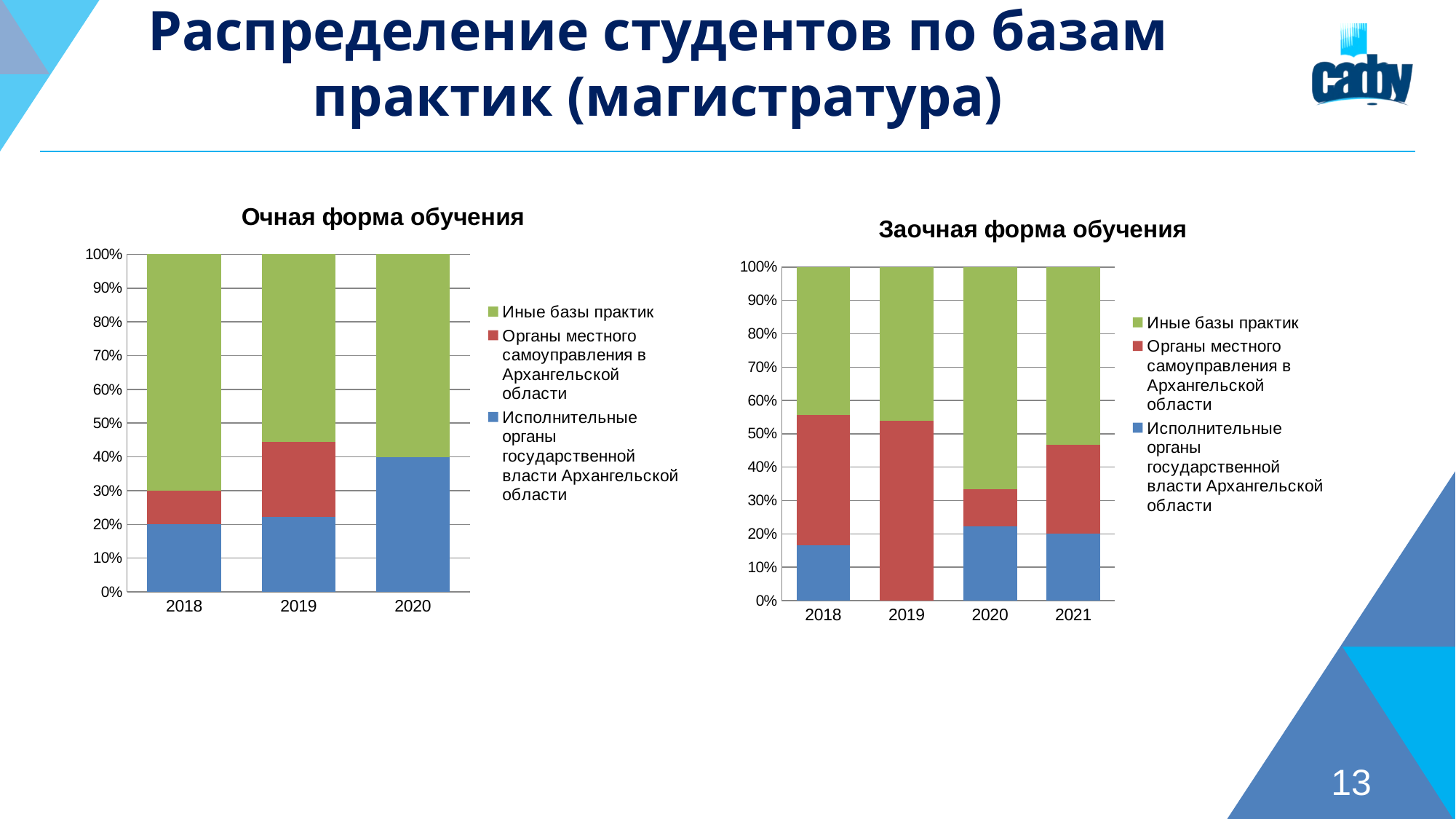
What colour represents 'Иные базы практик' in the 'Очная форма обучения' chart? green How many years are shown on the x axis of the 'Заочная форма обучения' chart? 4 In the 'Очная форма обучения' chart, is the share for 'Иные базы практик' in 2018 greater or less than 60%? greater How many years are shown on the x axis of the 'Очная форма обучения' chart? 3 In the 'Заочная форма обучения' chart, is the share for 'Иные базы практик' in 2020 greater or less than 60%? greater In the 'Очная форма обучения' chart, which year has the largest share for 'Исполнительные органы государственной власти Архангельской области'? 2020 In the 'Заочная форма обучения' chart, is the share for 'Исполнительные органы государственной власти Архангельской области' in 2018 greater or less than 20%? less What kind of chart is the 'Очная форма обучения' chart? stacked bar chart How many series does the legend of the 'Очная форма обучения' chart list? 3 In the 'Заочная форма обучения' chart, which year has no 'Исполнительные органы государственной власти Архангельской области' segment? 2019 In the 'Заочная форма обучения' chart, which year has the smallest share for 'Органы местного самоуправления в Архангельской области'? 2020